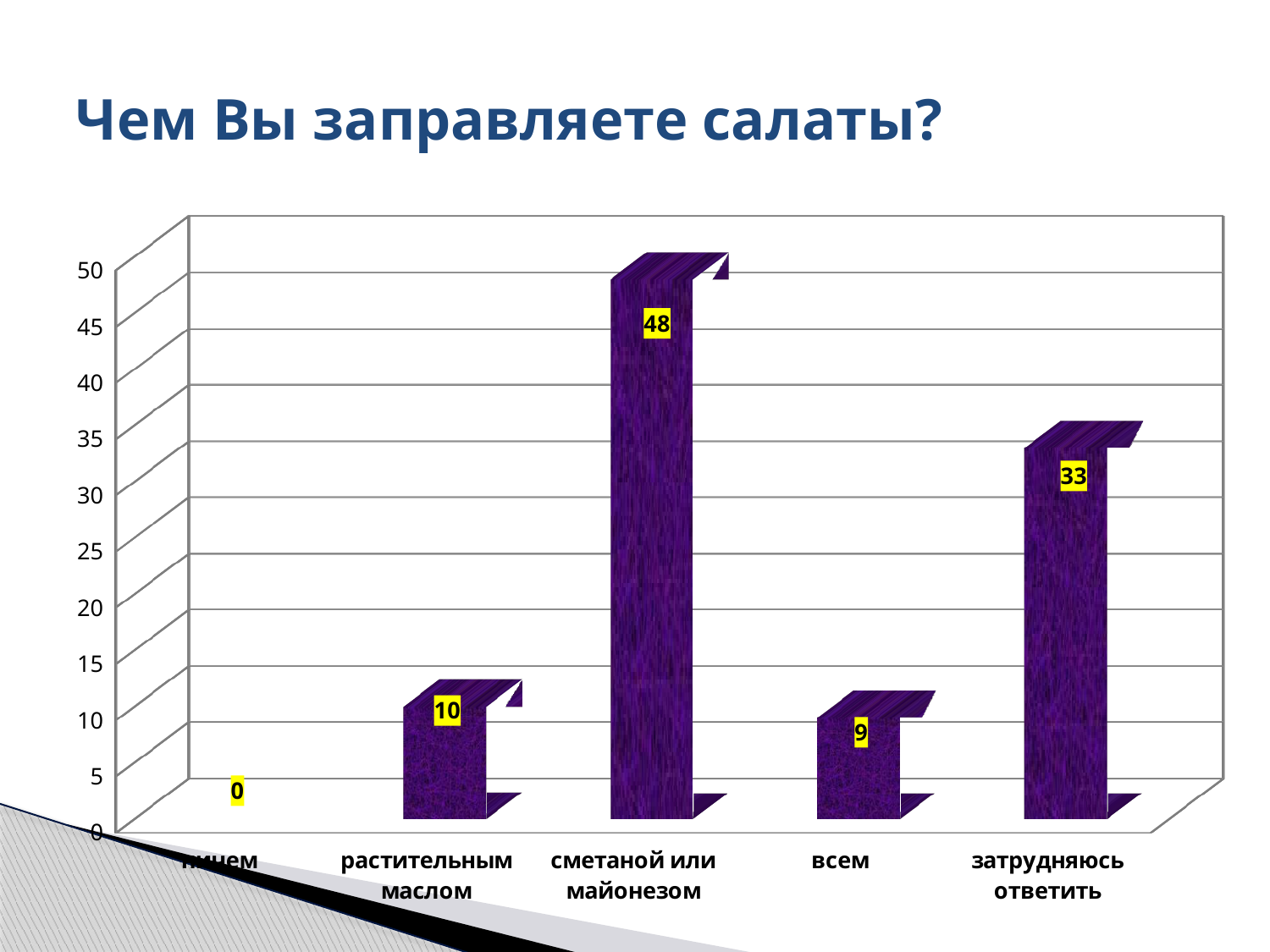
What is the value for «растительным маслом»? 10 How many categories are shown on the x axis? 5 What is the value for «затрудняюсь ответить»? 33 What is the difference between the values for «растительным маслом» and «всем»? 1 What is the title of the slide? Чем Вы заправляете салаты? What kind of chart is shown on the slide? bar chart What is the value for «сметаной или майонезом»? 48 Is the value for «затрудняюсь ответить» greater or less than 30? greater What is the value for «всем»? 9 Which category has the highest value? сметаной или майонезом Which is larger, the value for «растительным маслом» or the value for «всем»? растительным маслом What is the difference between the values for «сметаной или майонезом» and «затрудняюсь ответить»? 15